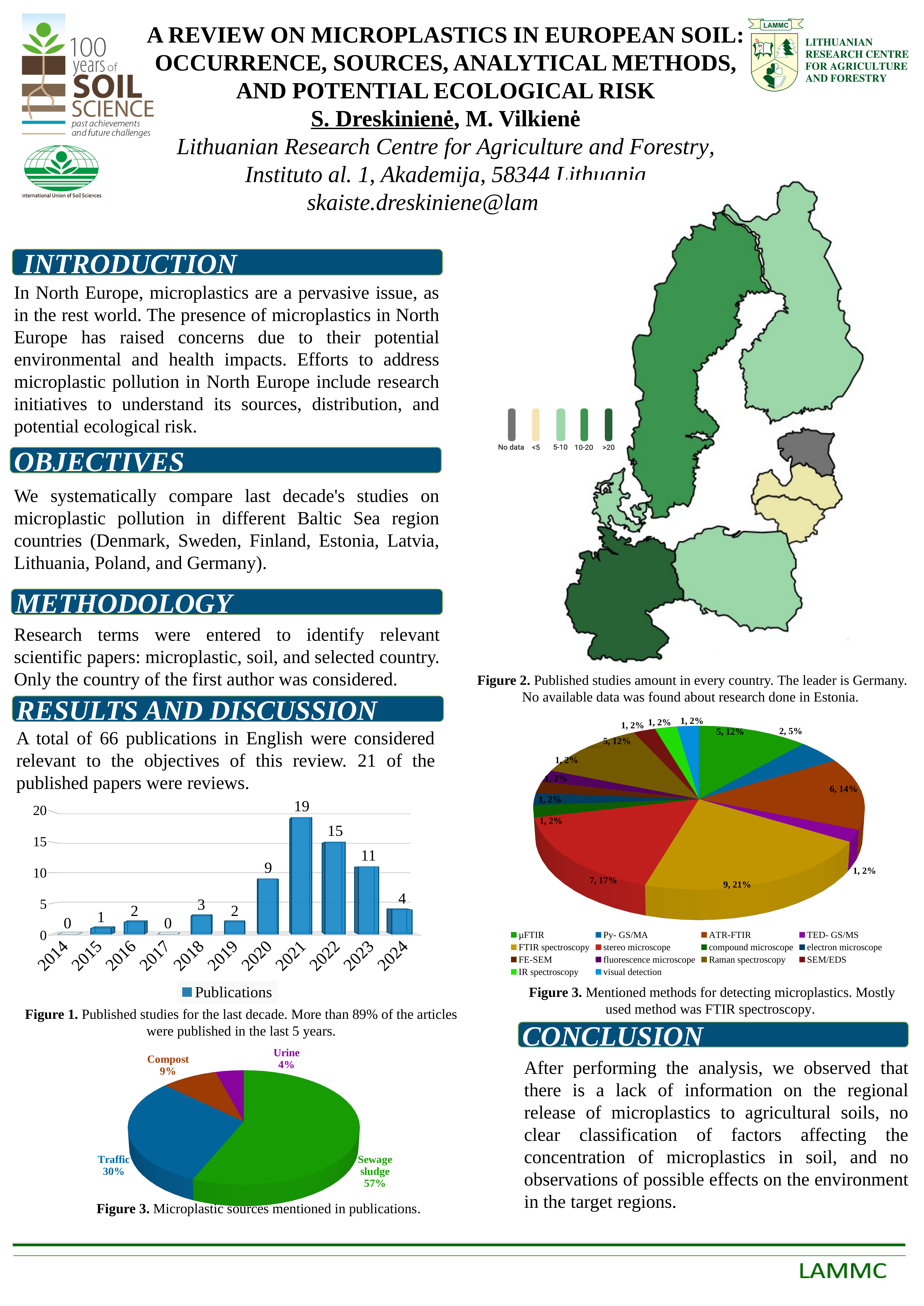
In the bar chart of publications by year, what is the difference between the publications in 2021 and 2022? 4 In the bar chart of publications by year, how many publications were there in 2020? 9 In the pie chart of detection methods, how many entries does the legend list? 14 In the pie chart of microplastic sources, what share does Sewage sludge have? 57% In the pie chart of microplastic sources, which source has the smallest share? Urine In the pie chart of microplastic sources, what is the difference between the Traffic share and the Compost share? 21% In the bar chart of publications by year, which year has the highest number of publications? 2021 In the bar chart of publications by year, what is the value for 2018? 3 In the bar chart of publications by year, which is larger, the value for 2023 or the value for 2024? 2023 What kind of chart is used to show publications by year in Figure 1? bar chart In the bar chart of publications by year, how many years are shown on the x axis? 11 In the bar chart of publications by year, how many publications were there in 2021? 19